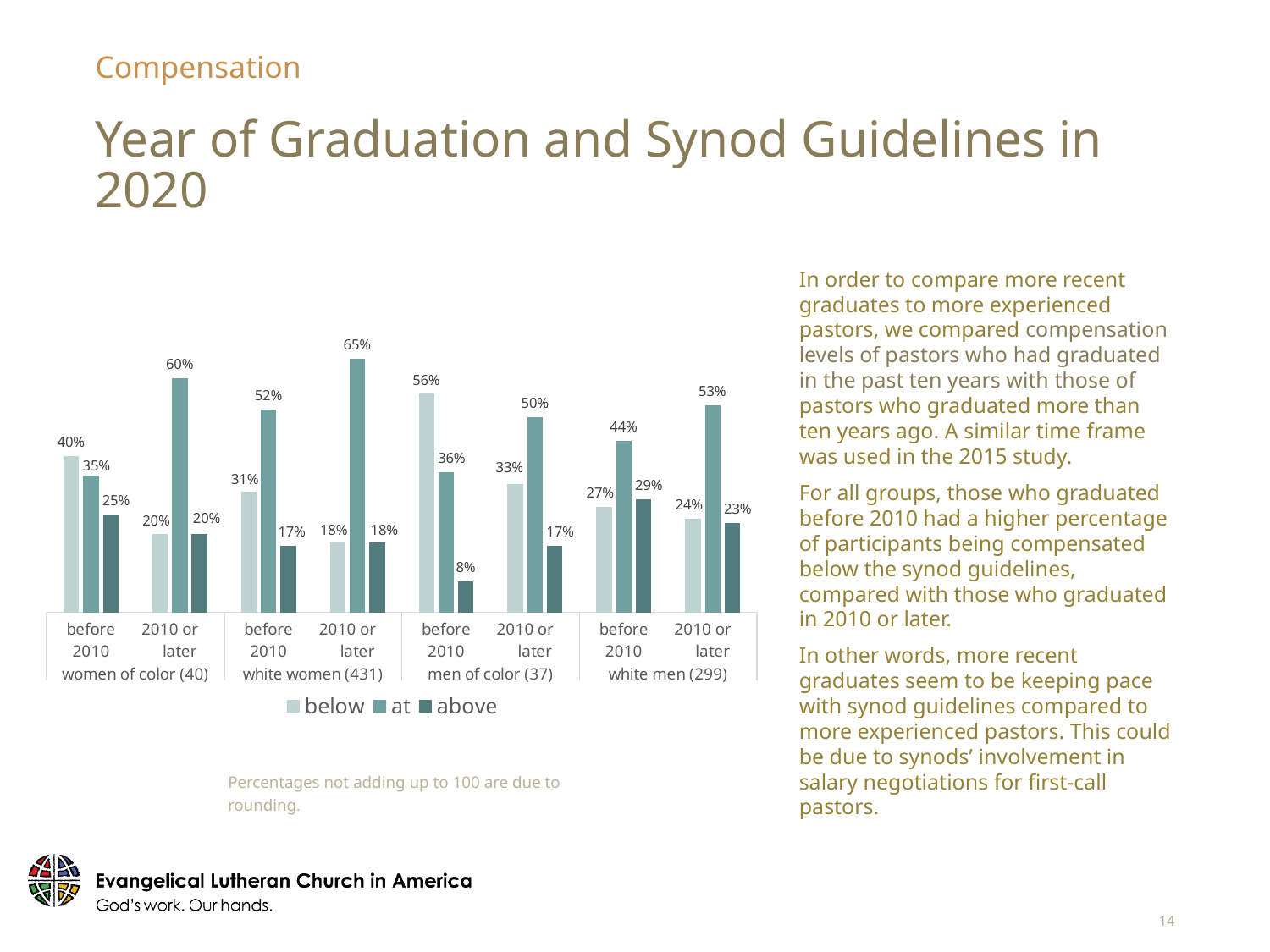
What is the difference between the 'at' values for white men who graduated in 2010 or later and those who graduated before 2010? 9% What are the three legend entries of the chart? below, at, above Which group and graduation period has the lowest 'above' value? men of color, before 2010 What kind of chart is shown on the slide? bar chart What is the 'below' value for white men who graduated in 2010 or later? 24% Which is larger for women of color who graduated before 2010: the 'below' value or the 'at' value? below Which group and graduation period has the highest 'at' value? white women, 2010 or later What is the 'at' value for white women who graduated in 2010 or later? 65% What is the difference between the 'below' values for men of color who graduated before 2010 and those who graduated in 2010 or later? 23% What is the 'below' value for white women who graduated before 2010? 31% How many series does the legend list? 3 What is the 'above' value for men of color who graduated before 2010? 8%